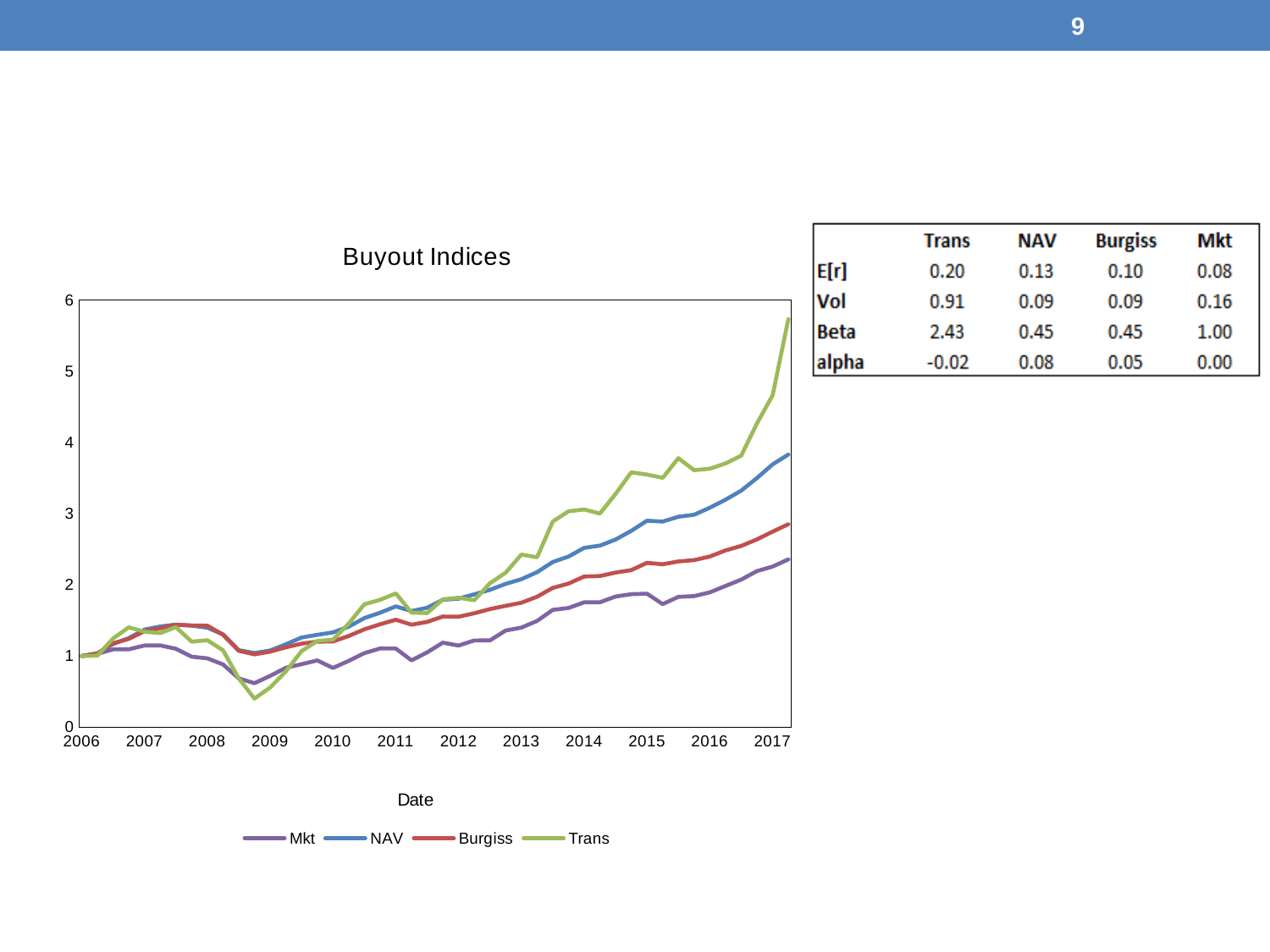
Is the value of the NAV series at the end of 2017 greater or less than 3? greater Is the value of the Trans series at the end of 2017 greater or less than 5? greater What is the label of the x axis of the Buyout Indices chart? Date Which series has the lowest value at the right end of the Buyout Indices chart (2017)? Mkt How many series does the legend of the Buyout Indices chart list? 4 Which series has the highest value at the right end of the Buyout Indices chart (2017)? Trans Which series dips to the lowest value around 2009 in the Buyout Indices chart? Trans What is the title of the chart on the slide? Buyout Indices Does the Mkt series generally rise or fall from 2009 to 2017? rise At the end of 2017, which series is larger, NAV or Burgiss? NAV What kind of chart is shown on the slide? line chart Is the value of the Mkt series at the end of 2017 greater or less than 3? less